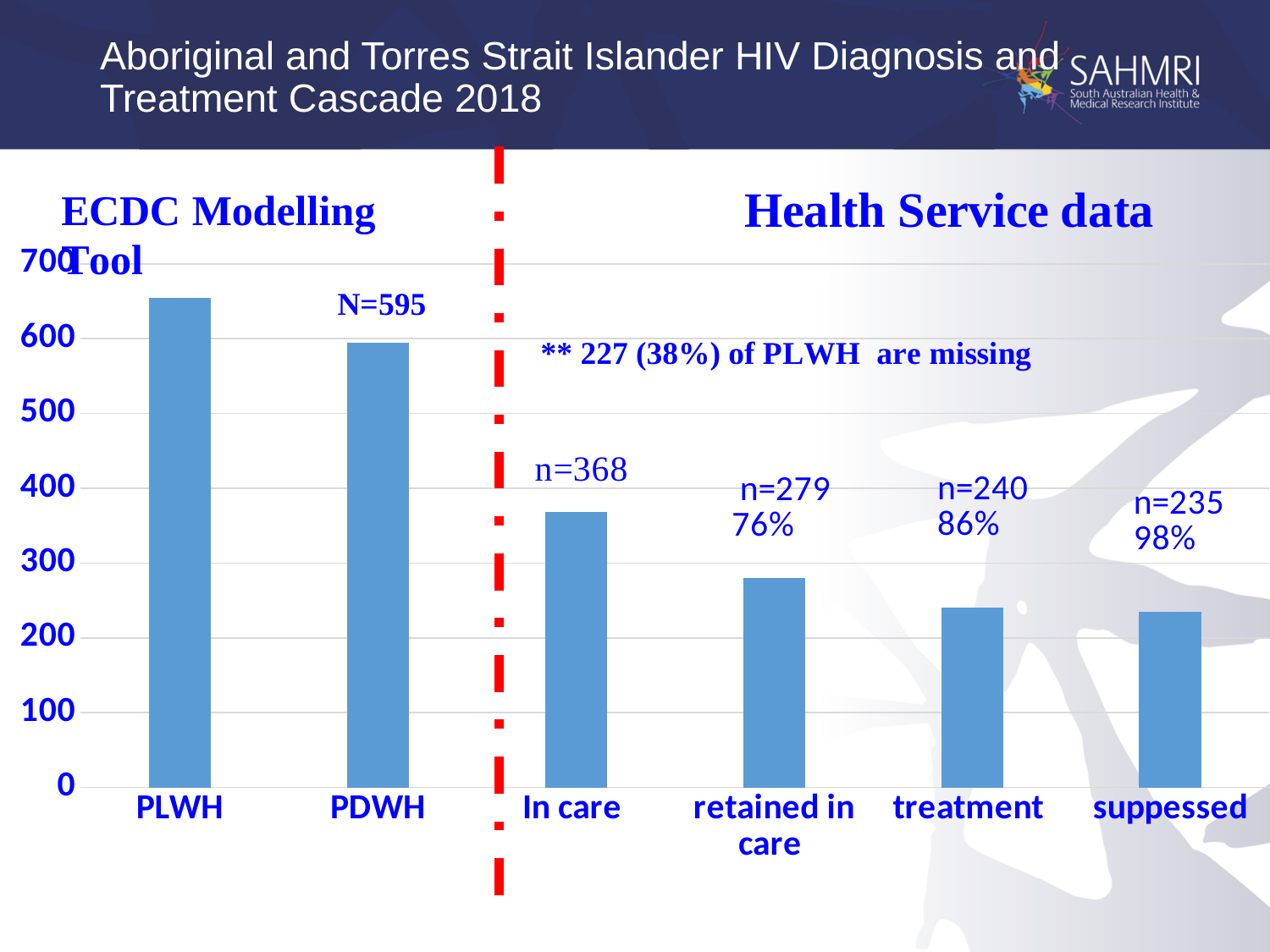
What is the value labelled for In care? n=368 What percentage is shown above the treatment bar? 86% Is the value for PLWH greater or less than 600? greater What kind of chart is shown on the slide? bar chart What is the value labelled for retained in care? n=279 Do the bar values rise or fall moving from left to right along the x axis? fall What is the difference between the PDWH value (595) and the In care value (368)? 227 According to the annotation on the chart, what percentage of PLWH are missing? 38% What is the value labelled for suppessed? n=235 What is the value labelled for PDWH? N=595 Which category has the highest bar? PLWH How many categories are shown on the x axis of the chart? 6